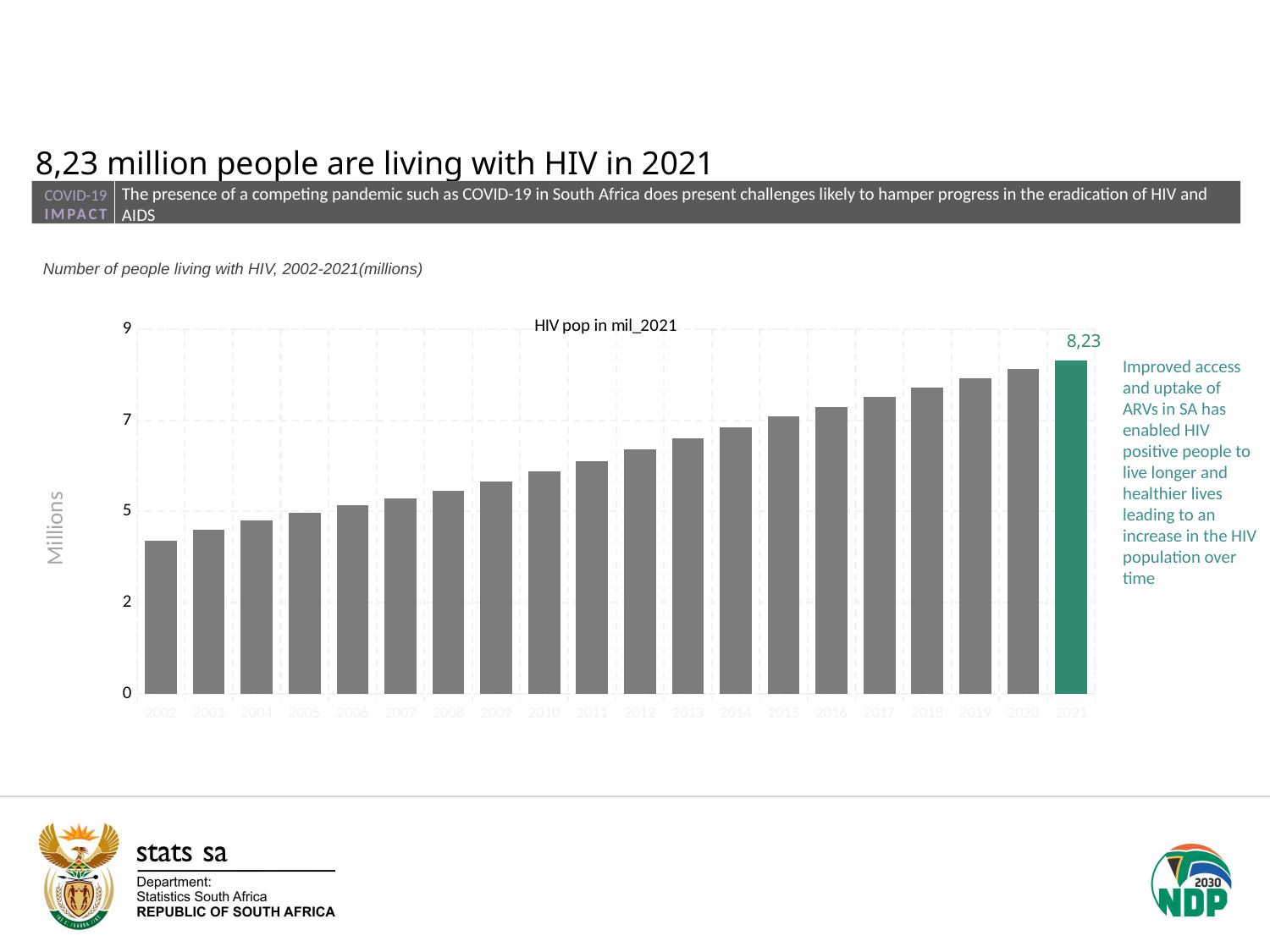
Which year has the larger value, 2010 or 2015? 2015 Which year has the lowest number of people living with HIV in the chart? 2002 Do the values in the chart rise or fall from 2002 to 2021? rise What is the value shown for 2021 in the chart? 8,23 Which year has the highest number of people living with HIV in the chart? 2021 How many years (bars) are plotted in the chart? 20 What colour is the bar for 2021 in the chart? green What is the title shown above the chart? HIV pop in mil_2021 Is the value for 2010 greater or less than 5? greater What kind of chart is shown on the slide? bar chart Is the value for 2002 greater or less than 5? less